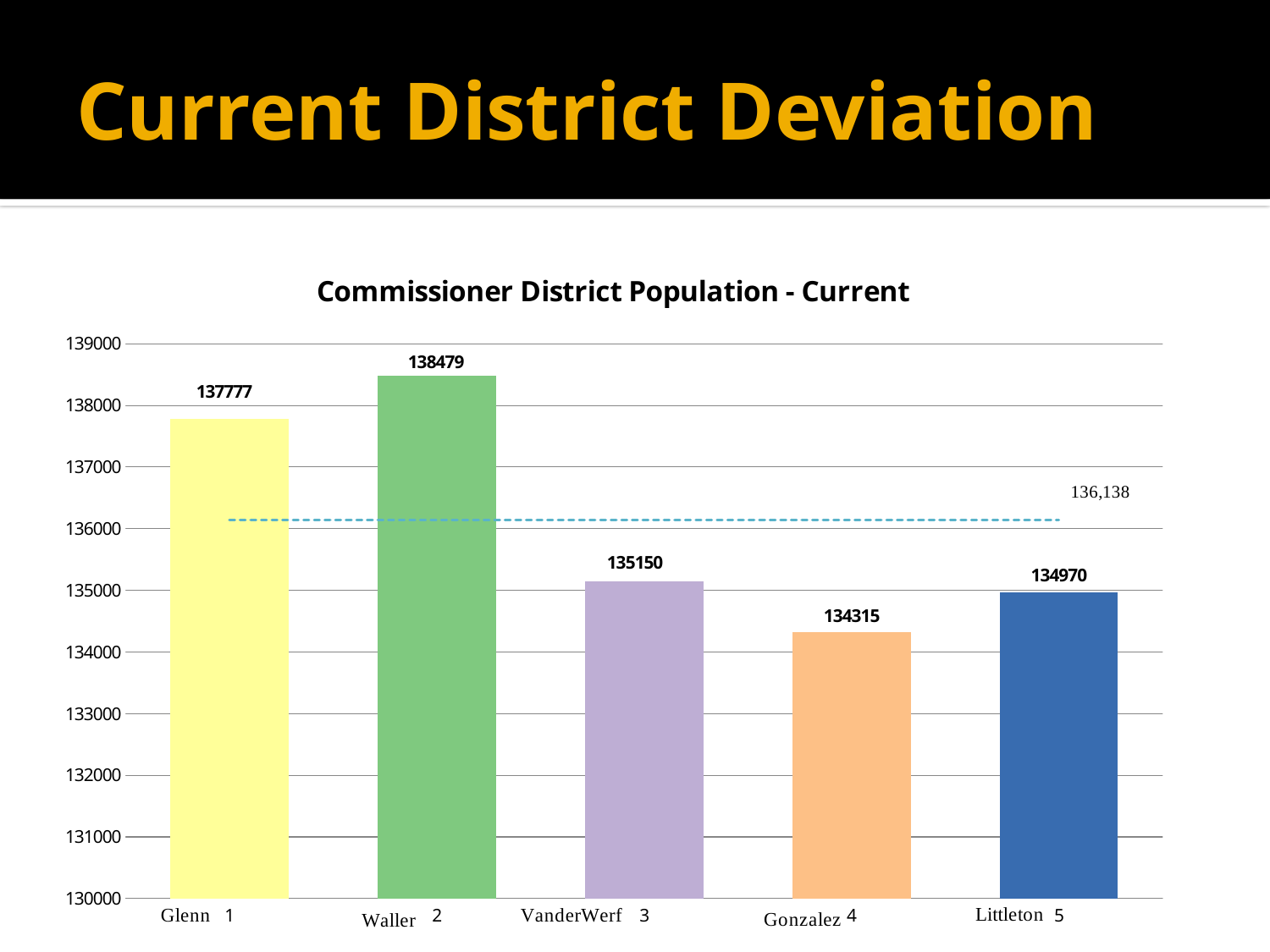
What kind of chart is shown on the slide? bar chart Which has a larger population, Glenn or VanderWerf? Glenn What value is labelled on the dashed horizontal line in the chart? 136,138 Is the value for Littleton greater or less than 136000? less What is the difference between the populations of Waller and Gonzalez? 4164 Which district has the highest population in the chart? Waller (2) What is the difference between the populations of VanderWerf and Littleton? 180 Which district has the lowest population in the chart? Gonzalez (4) How many districts are shown in the chart? 5 What is the population value shown for Gonzalez (district 4)? 134315 What is the population value shown for Glenn (district 1)? 137777 What is the population value shown for Waller (district 2)? 138479